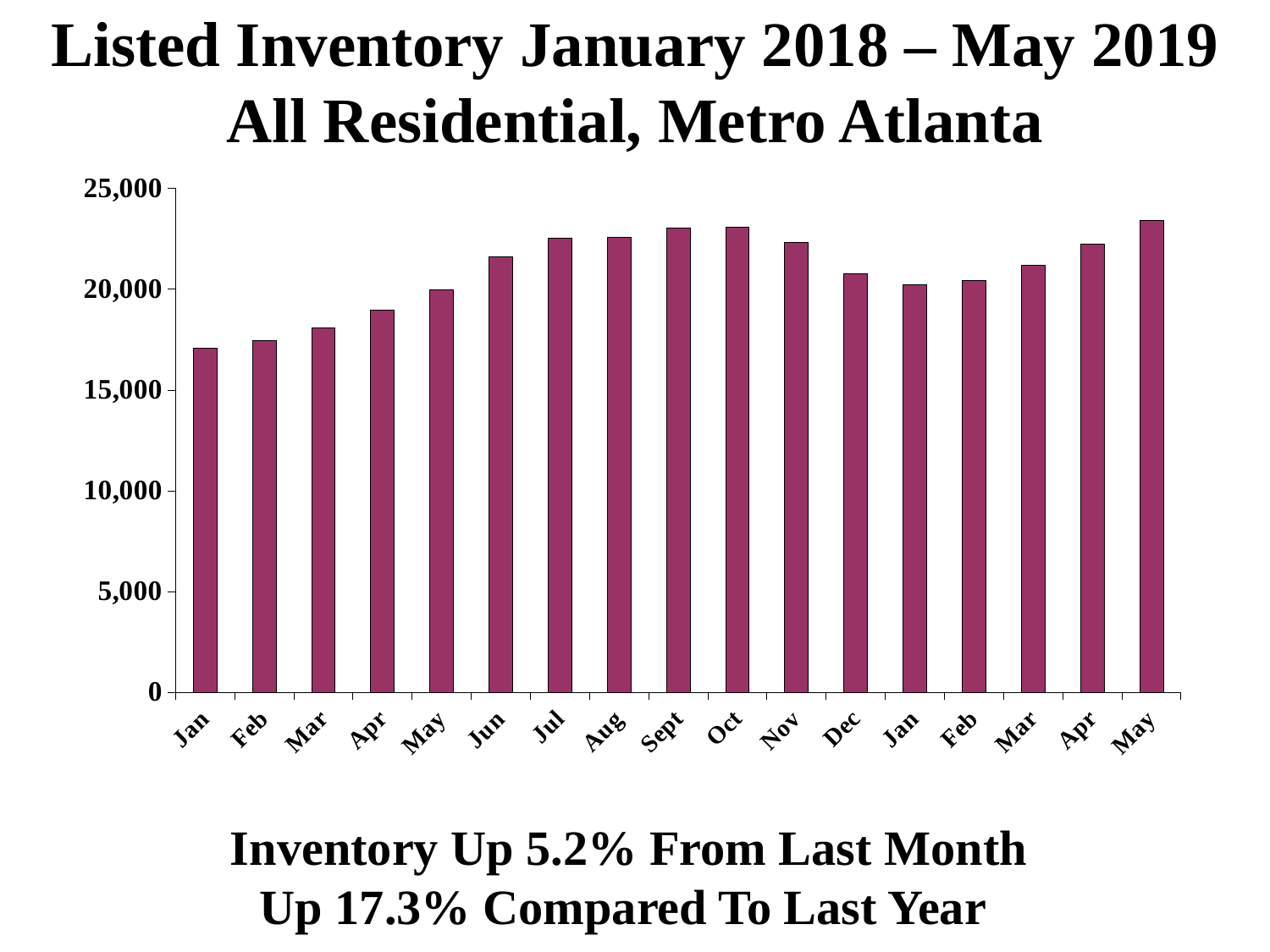
Which is larger, the value for Oct or the value for Dec? Oct Which is larger, the value for the first Jan bar (January 2018) or the value for Sept? Sept Is the value for Sept greater or less than 20,000? greater Is the value for Jun greater or less than 15,000? greater Is the value for Apr 2018 (the first Apr bar) greater or less than 20,000? less Which is larger, the value for the first Apr bar (April 2018) or the second Apr bar (April 2019)? April 2019 What is the title of the chart? Listed Inventory January 2018 – May 2019 All Residential, Metro Atlanta Do the values rise or fall from Jan 2018 through Oct 2018? rise How many monthly bars are plotted in the chart? 17 What kind of chart is shown on the slide? bar chart